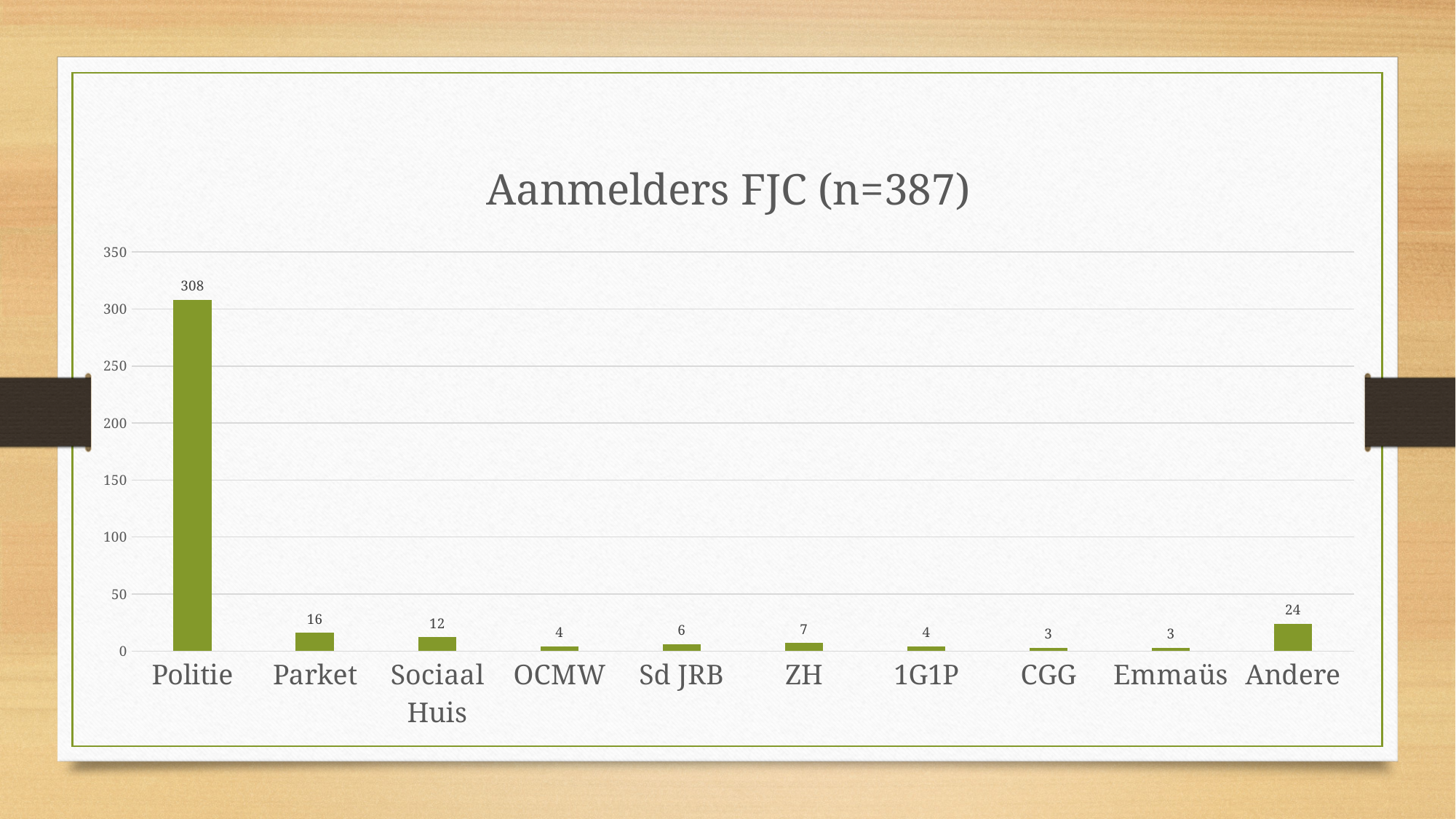
What is the difference between the values for Politie and Andere? 284 Is the value for Politie greater or less than 300? greater Which category has the highest value? Politie What is the value for ZH? 7 How many categories are shown on the x axis? 10 What is the title of the chart? Aanmelders FJC (n=387) What is the value for Politie? 308 What is the difference between the values for Parket and Sociaal Huis? 4 Which is larger, the value for Parket or the value for Andere? Andere What kind of chart is shown on the slide? bar chart What is the value for Sociaal Huis? 12 What is the value for Andere? 24